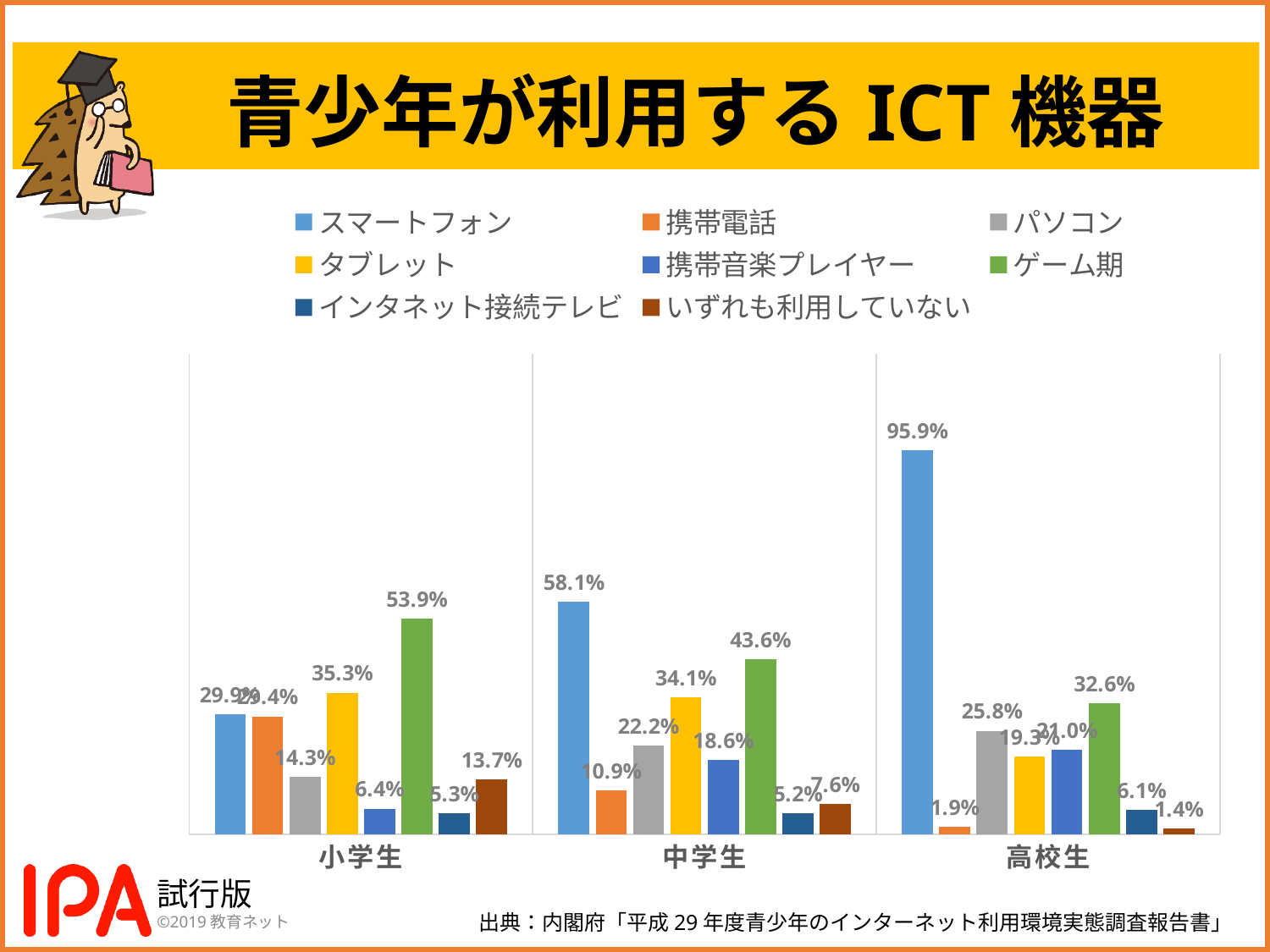
What is the value for パソコン in the 高校生 category? 25.8% What is the difference between スマートフォン and 携帯電話 in the 中学生 category? 47.2% Which category has the highest value for スマートフォン? 高校生 In the 小学生 category, which is larger: タブレット or ゲーム期? ゲーム期 What kind of chart is shown on the slide? Bar chart How many categories are shown on the x axis? 3 What is the value for ゲーム期 in the 小学生 category? 53.9% Which series has the lowest value in the 高校生 category? いずれも利用していない What is the value for タブレット in the 中学生 category? 34.1% How many series does the legend list? 8 What is the value for スマートフォン in the 高校生 category? 95.9% Does the value for スマートフォン rise or fall from 小学生 to 高校生? Rises